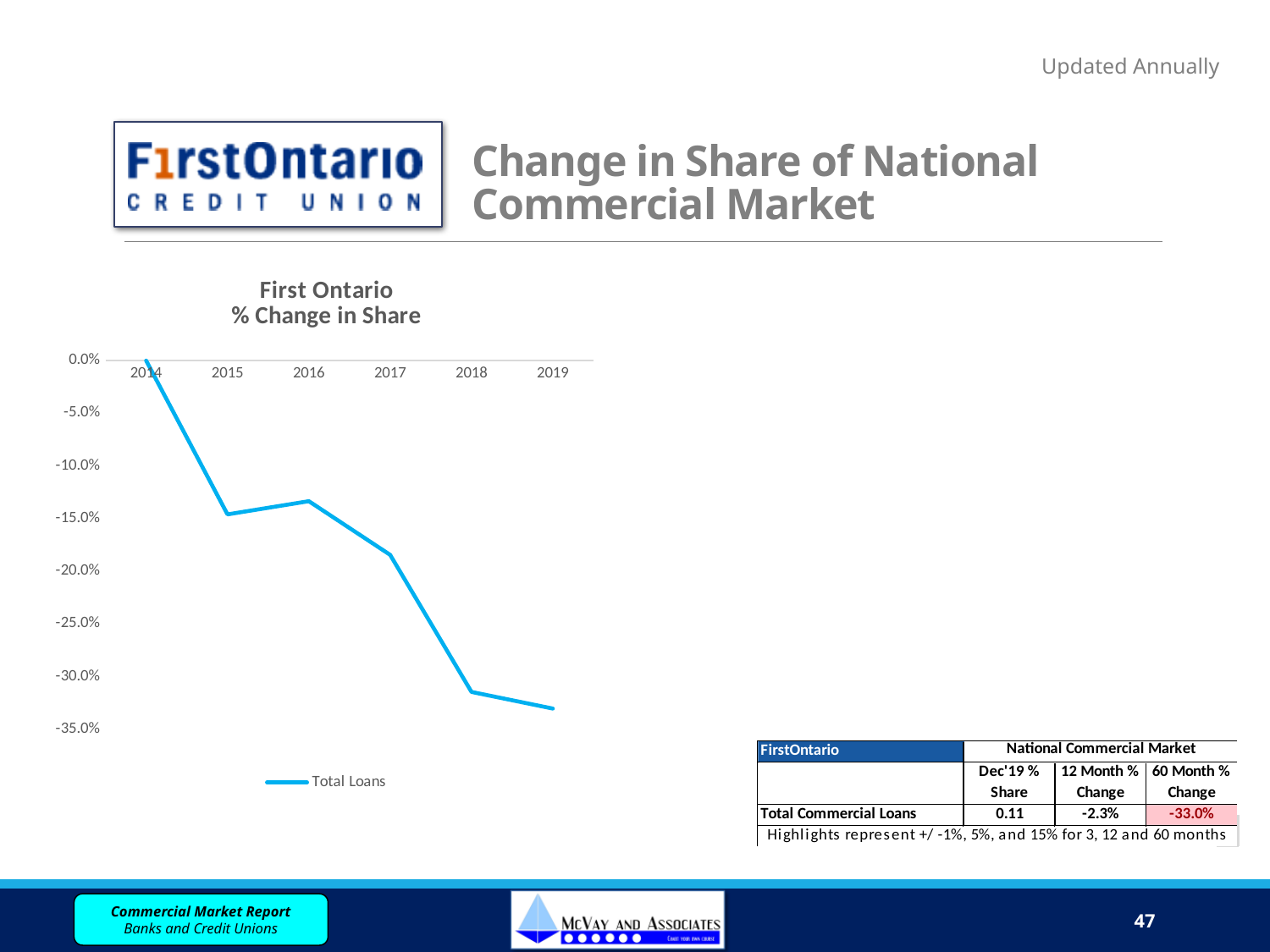
How many years are plotted along the x axis of the chart? 6 What is the value for Total Loans in 2014? 0.0% What is the title of the chart? First Ontario % Change in Share Is the value for Total Loans in 2016 greater or less than -15.0%? greater How many series does the chart legend list? 1 What is the name of the series shown in the legend? Total Loans What kind of chart is shown on the slide? line chart Which year has the lowest value for Total Loans? 2019 Is the value for Total Loans in 2018 greater or less than -30.0%? less Do the values for Total Loans generally rise or fall from 2014 to 2019? fall Which is larger, the value for Total Loans in 2015 or in 2017? 2015 Which year has the highest value for Total Loans? 2014